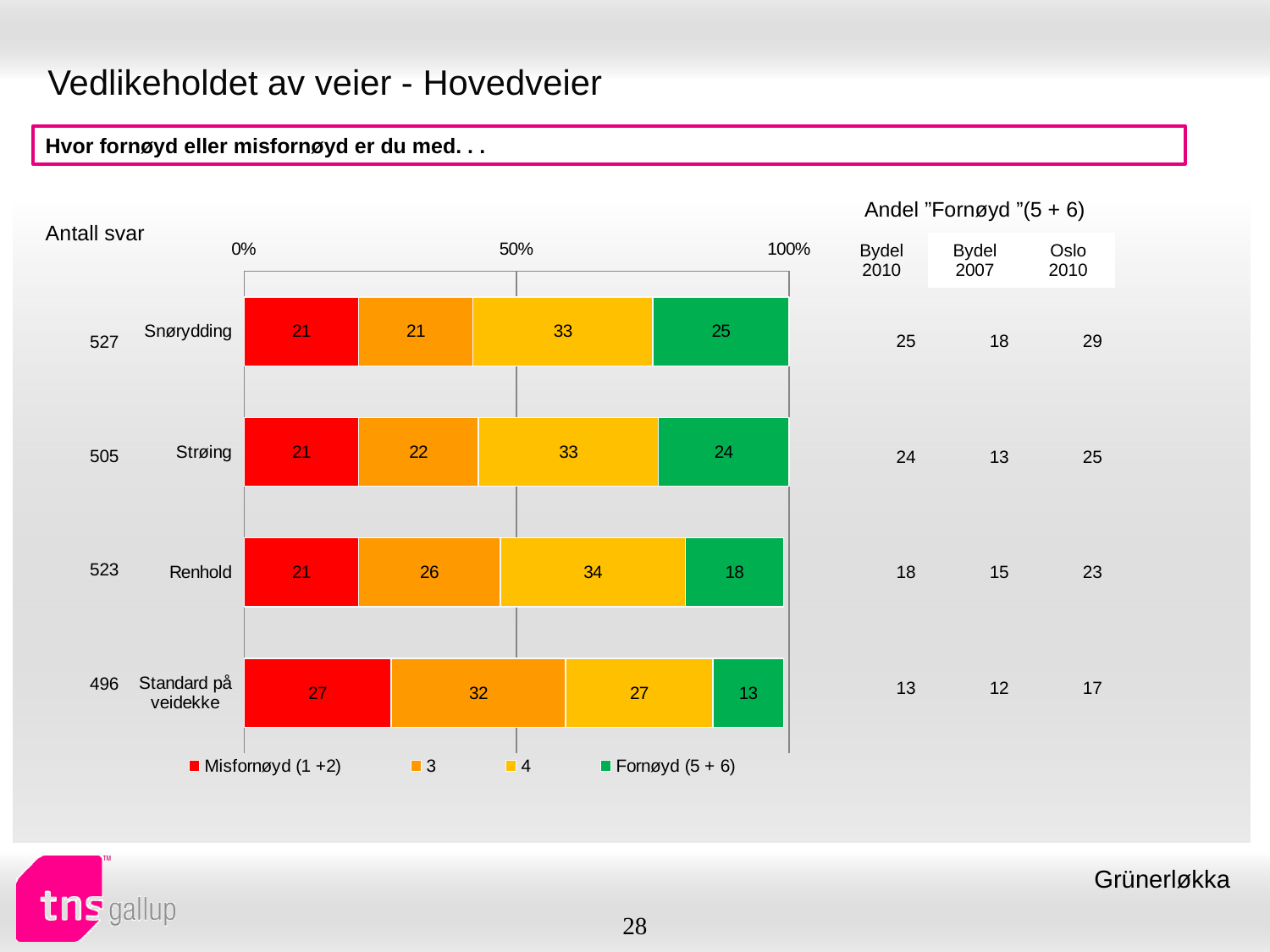
What is the value of the Misfornøyd (1 +2) segment for Standard på veidekke? 27 What is the value of the Fornøyd (5 + 6) segment for Snørydding? 25 What is the total of the stacked bar for Strøing? 100 What is the value of the '4' segment for Renhold? 34 Which category has the highest Fornøyd (5 + 6) value? Snørydding What colour represents the Fornøyd (5 + 6) series in the legend? green How many series does the legend list? 4 Which category has the lowest Fornøyd (5 + 6) value? Standard på veidekke What kind of chart is shown on the slide? stacked bar chart How many categories are plotted in the chart? 4 Which is larger: the '3' segment for Renhold or the '3' segment for Strøing? Renhold What is the difference between the Fornøyd (5 + 6) values for Snørydding and Standard på veidekke? 12